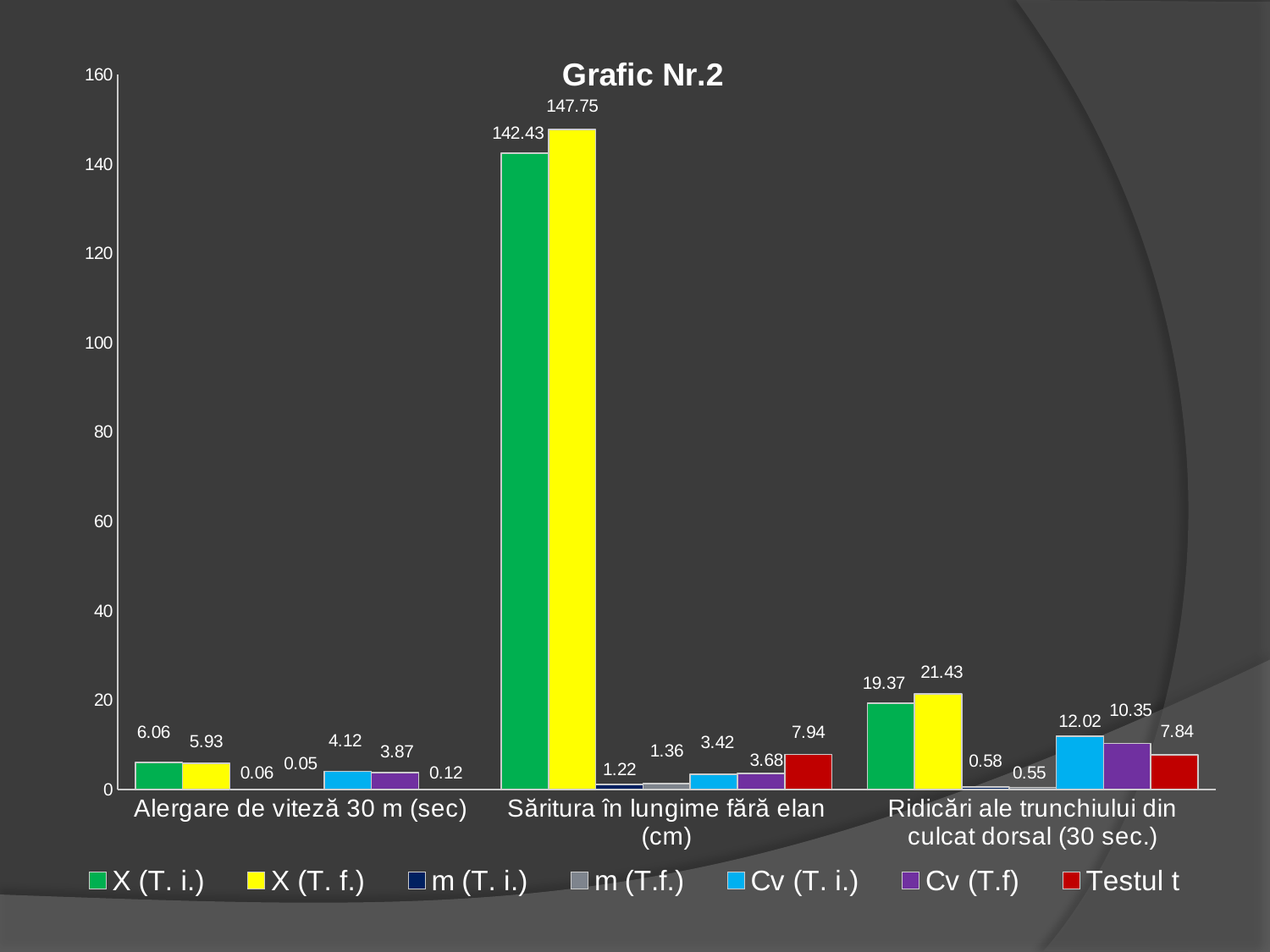
Is the value of X (T. i.) for Săritura în lungime fără elan (cm) greater or less than 140? greater How many categories are shown on the x axis? 3 What is the difference between X (T. f.) and X (T. i.) for Săritura în lungime fără elan (cm)? 5.32 What is the value of Testul t for Alergare de viteză 30 m (sec)? 0.12 Which is larger for Ridicări ale trunchiului din culcat dorsal (30 sec.): Cv (T. i.) or Cv (T.f)? Cv (T. i.) How many series does the legend list? 7 Which category has the highest X (T. i.) value? Săritura în lungime fără elan (cm) What type of chart is shown? Bar chart Which category has the lowest Testul t value? Alergare de viteză 30 m (sec) What is the value of Cv (T. i.) for Ridicări ale trunchiului din culcat dorsal (30 sec.)? 12.02 What is the value of X (T. f.) for Săritura în lungime fără elan (cm)? 147.75 What is the value of m (T.f.) for Săritura în lungime fără elan (cm)? 1.36